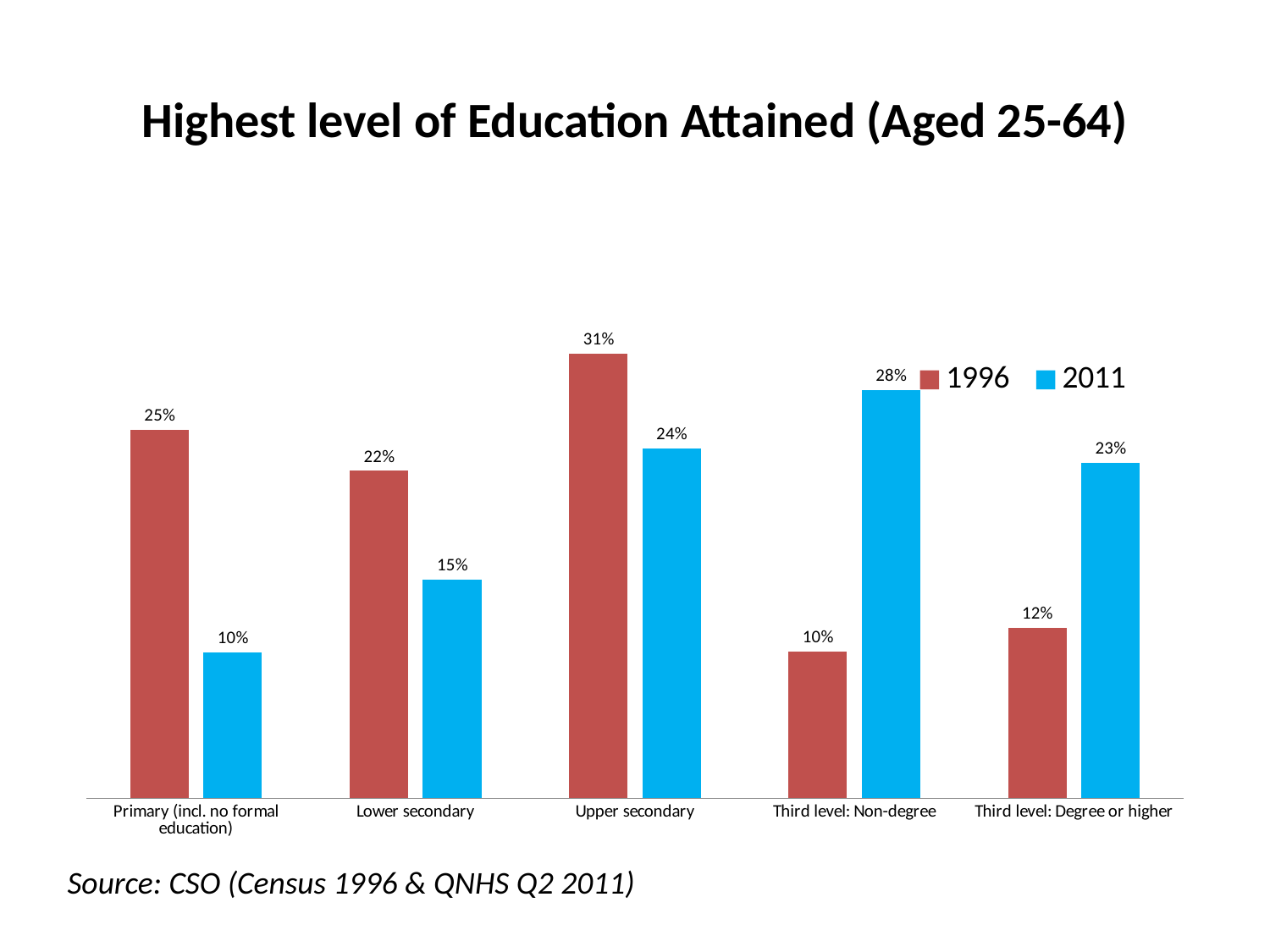
Which is larger for Third level: Degree or higher, the 1996 value or the 2011 value? 2011 What is the difference between the 1996 and 2011 values for Lower secondary? 7% What is the 2011 value for Primary (incl. no formal education)? 10% How many education categories are shown on the x axis? 5 What is the title of the chart? Highest level of Education Attained (Aged 25-64) What is the 1996 value for Upper secondary? 31% How many series does the legend list? 2 Which category has the lowest 2011 value? Primary (incl. no formal education) What is the 1996 value for Third level: Degree or higher? 12% What kind of chart is shown on the slide? Bar chart Which category has the highest 1996 value? Upper secondary What is the 2011 value for Third level: Non-degree? 28%